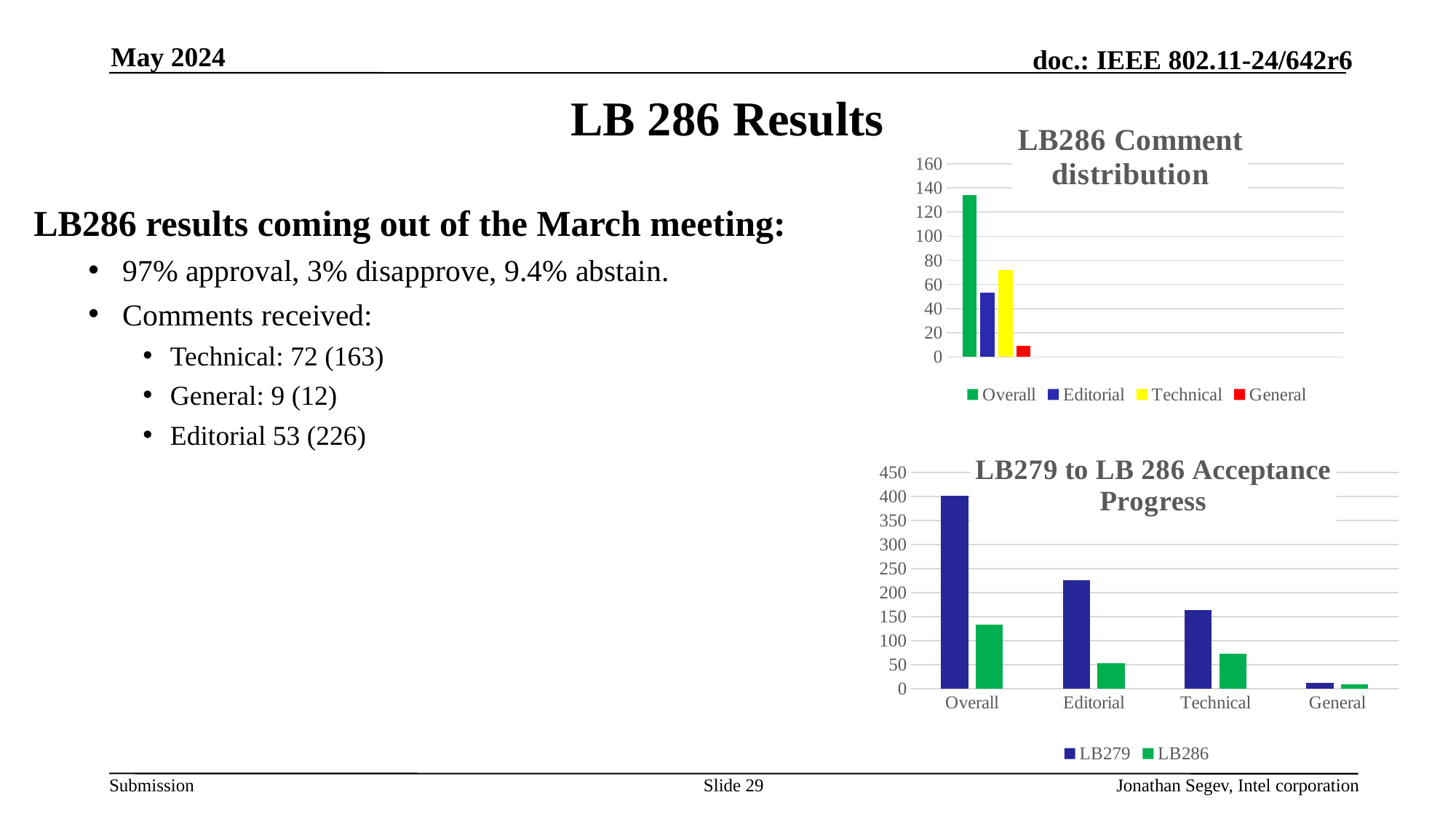
In the LB279 to LB 286 Acceptance Progress chart, which is larger for Editorial, LB279 or LB286? LB279 How many series does the legend of the LB286 Comment distribution chart list? 4 What are the two series listed in the legend of the LB279 to LB 286 Acceptance Progress chart? LB279 and LB286 In the LB279 to LB 286 Acceptance Progress chart, is the LB279 value for Overall greater or less than 350? greater How many categories are shown on the x axis of the LB279 to LB 286 Acceptance Progress chart? 4 In the LB286 Comment distribution chart, is the value for Editorial greater or less than 60? less In the LB286 Comment distribution chart, which is larger, Technical or Editorial? Technical What kind of chart is the LB279 to LB 286 Acceptance Progress chart? bar chart In the LB286 Comment distribution chart, is the value for Overall greater or less than 120? greater In the LB286 Comment distribution chart, which series has the tallest bar? Overall In the LB279 to LB 286 Acceptance Progress chart, which category has the highest LB279 value? Overall In the LB286 Comment distribution chart, which series has the shortest bar? General